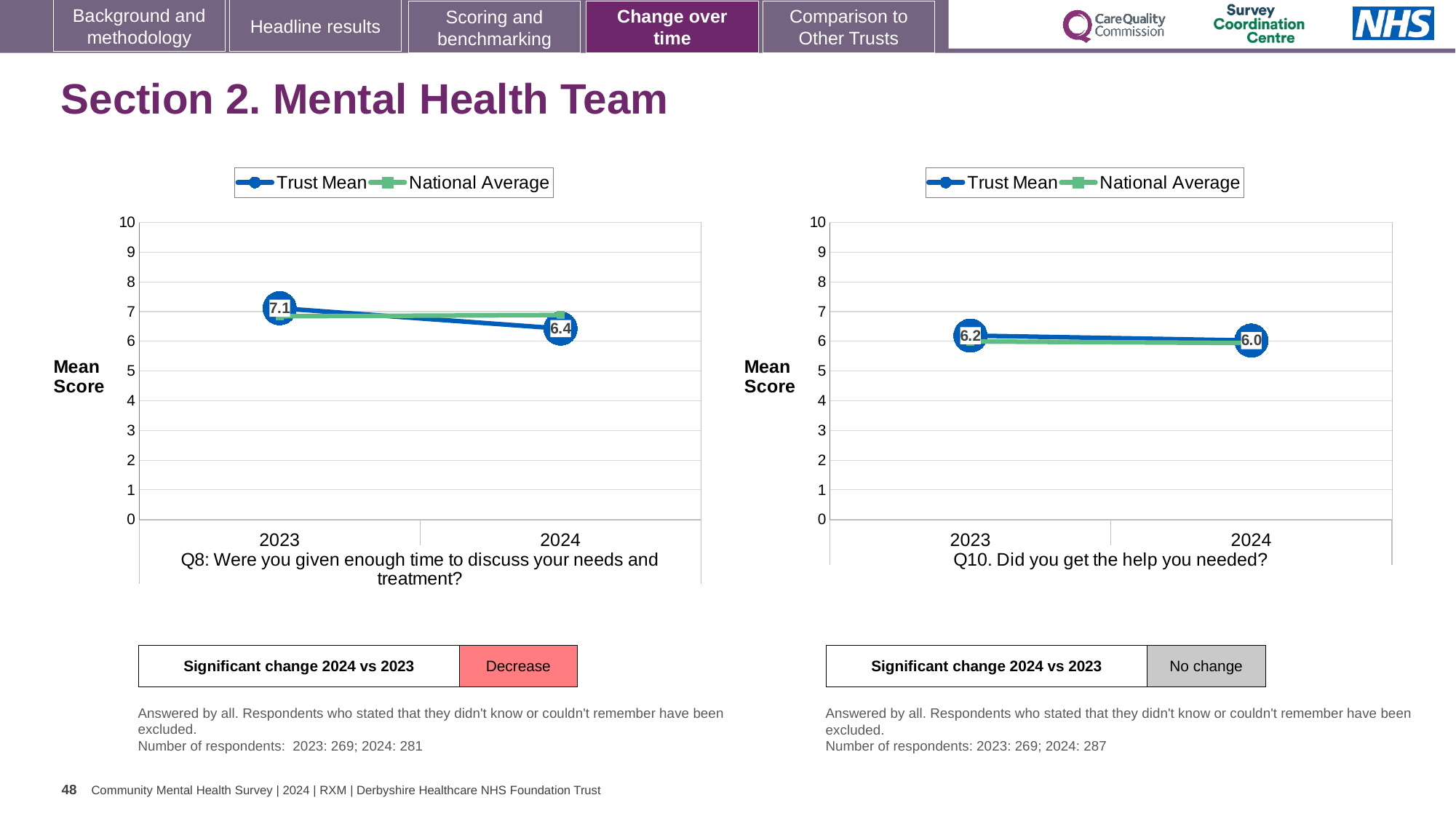
In the Q10 chart (right), what is the Trust Mean for 2024? 6.0 In the Q8 chart (left), is the National Average for 2024 greater or less than 6? greater In the Q10 chart (right), what is the difference between the Trust Mean in 2023 and 2024? 0.2 In the Q10 chart (right), what is the Trust Mean for 2023? 6.2 What kind of chart is the Q10 chart (right)? line chart In the Q8 chart (left), by how much did the Trust Mean fall from 2023 to 2024? 0.7 In the Q8 chart (left), does the Trust Mean rise or fall from 2023 to 2024? fall What does the 'Significant change 2024 vs 2023' box below the Q8 chart (left) say? Decrease How many years are shown on the x axis of the Q10 chart (right)? 2 In the Q8 chart (left), what is the Trust Mean for 2024? 6.4 How many series does the legend of the Q8 chart (left) list? 2 In the Q8 chart (left), what is the Trust Mean for 2023? 7.1